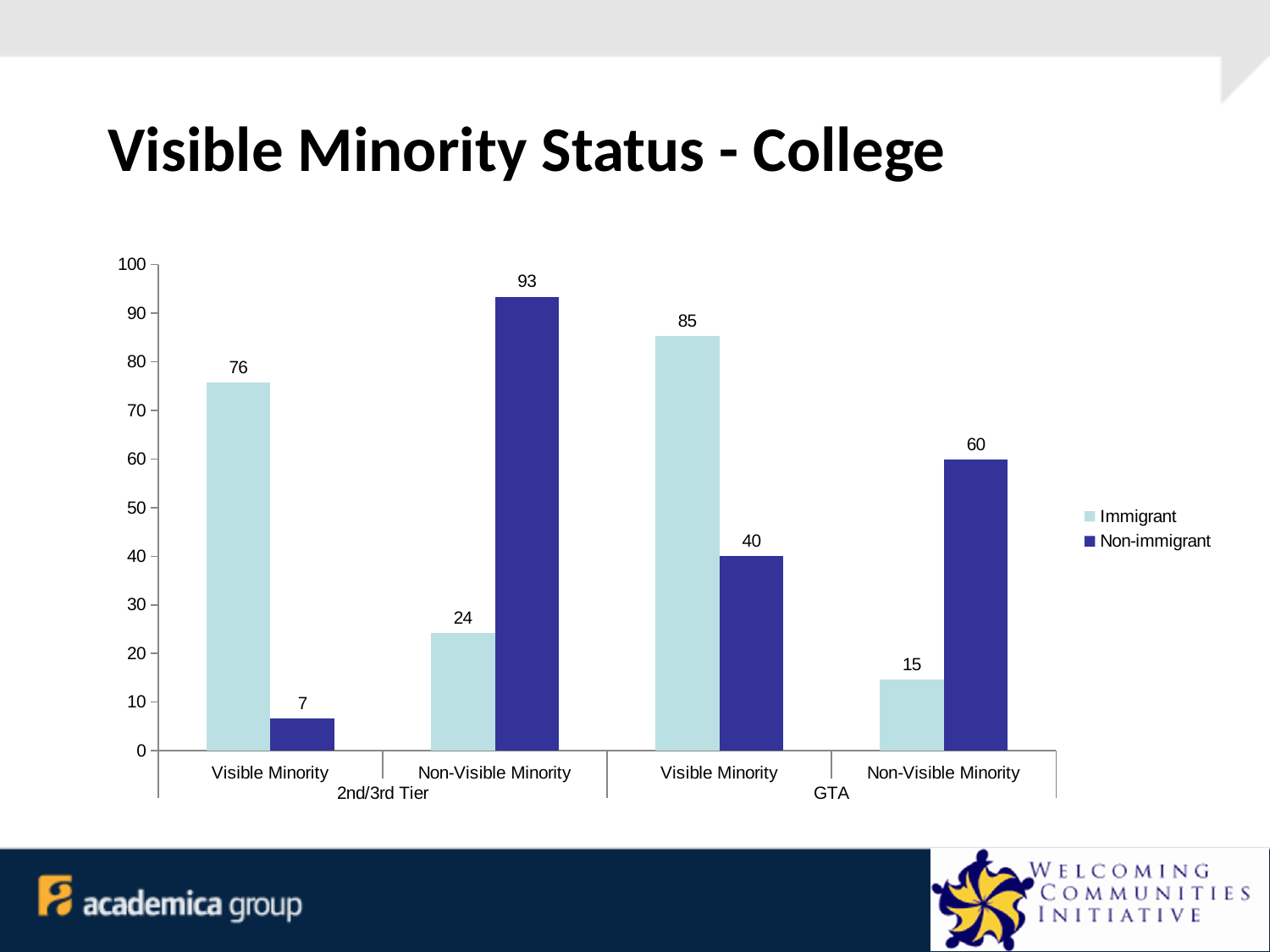
How many bars are plotted in the chart? 8 What is the Non-immigrant value for Non-Visible Minority in the GTA group? 60 Which is larger: the Immigrant value for Non-Visible Minority in the 2nd/3rd Tier group or the Immigrant value for Non-Visible Minority in the GTA group? 2nd/3rd Tier (24) What kind of chart is shown on the slide? bar chart What is the difference between the Immigrant and Non-immigrant values for Visible Minority in the GTA group? 45 What is the Immigrant value for Visible Minority in the 2nd/3rd Tier group? 76 Which series is shown in dark blue in the legend? Non-immigrant How many series does the legend list? 2 Which category has the highest Non-immigrant value? Non-Visible Minority (2nd/3rd Tier) What is the Non-immigrant value for Visible Minority in the 2nd/3rd Tier group? 7 Is the Non-immigrant value for Visible Minority in the GTA group greater or less than 50? less Which category has the lowest Immigrant value? Non-Visible Minority (GTA)